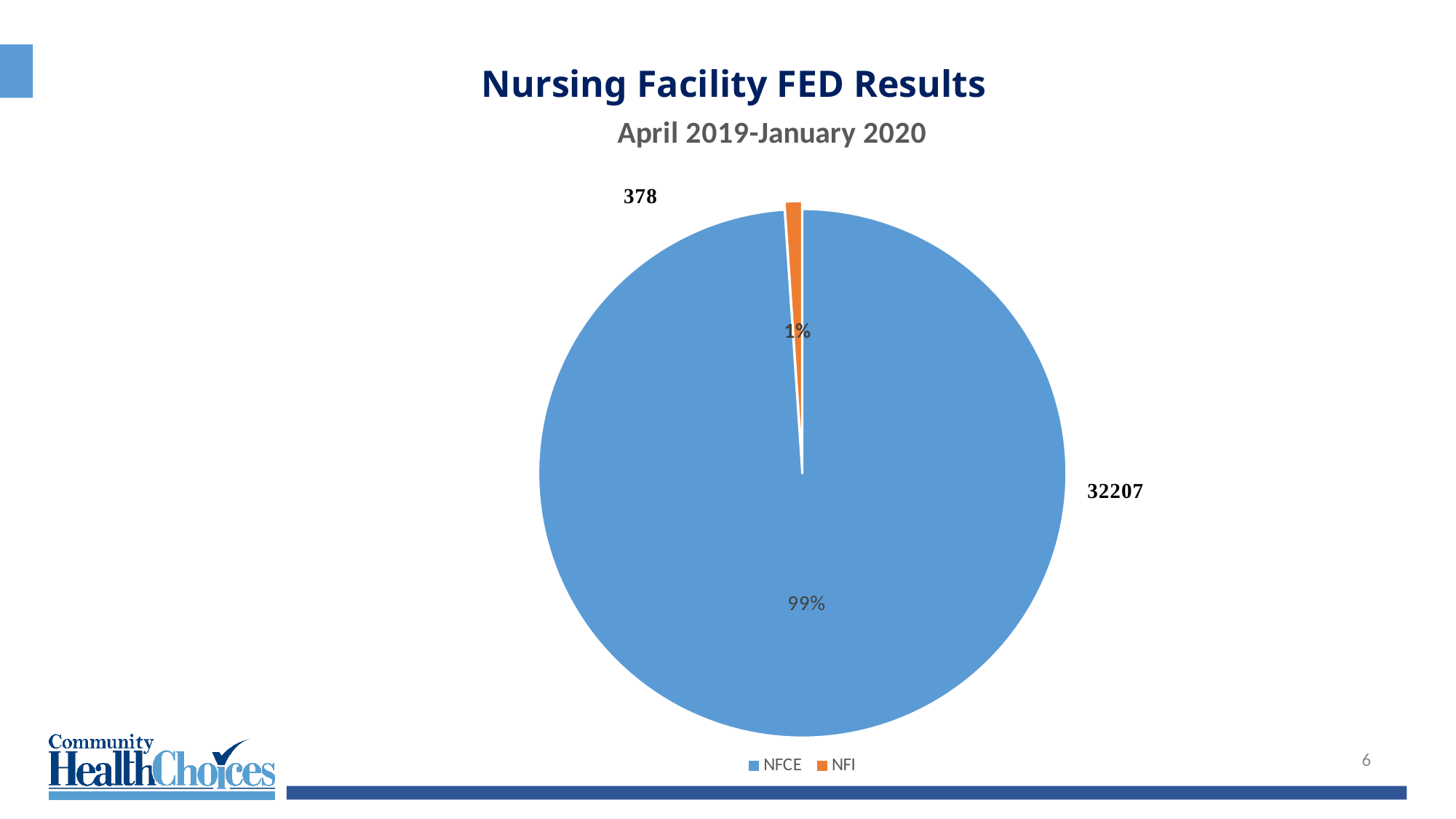
What is the difference between the NFCE and NFI values? 31829 What is the total of the two values shown in the pie chart? 32585 What share of the pie does NFCE represent? 99% Which is larger, NFCE or NFI? NFCE What is the value for NFI? 378 Which category has the smallest slice? NFI How many categories does the pie chart show? 2 What share of the pie does NFI represent? 1% Which category has the largest slice? NFCE What is the chart's title? April 2019-January 2020 What type of chart is shown on the slide? pie chart What is the value for NFCE? 32207